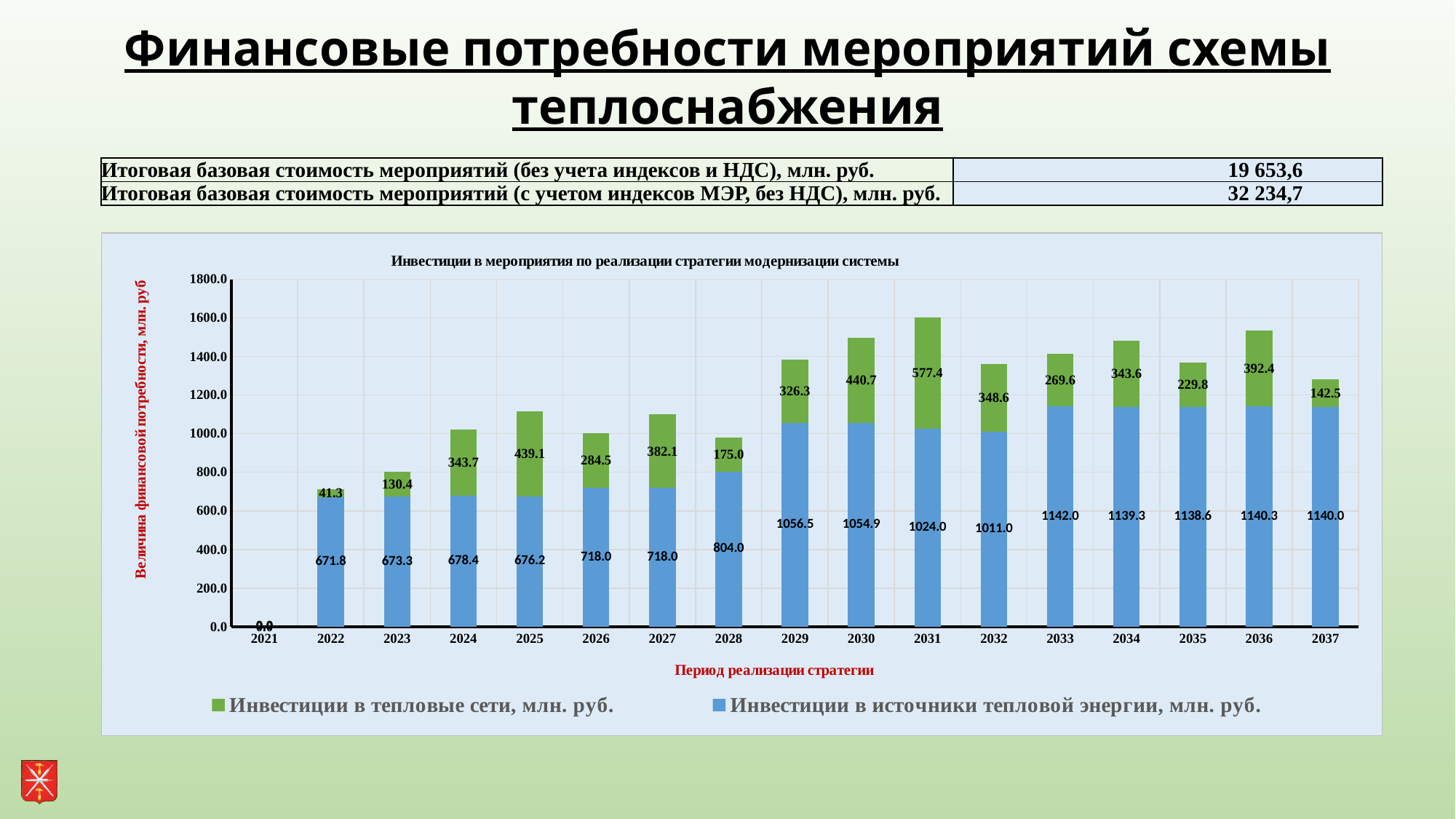
Which is larger: 'Инвестиции в тепловые сети, млн. руб.' in 2024 or in 2027? 2027 How many series does the chart legend list? 2 What is the difference between 'Инвестиции в тепловые сети, млн. руб.' in 2031 and in 2030? 136.7 What is the value of 'Инвестиции в источники тепловой энергии, млн. руб.' for 2028? 804.0 What is the value of 'Инвестиции в тепловые сети, млн. руб.' for 2031? 577.4 Among the years with a non-zero value, in which year is 'Инвестиции в тепловые сети, млн. руб.' the lowest? 2022 What type of chart is shown on the slide? bar chart What is the total height of the stacked bar for 2031? 1601.4 How many years are shown on the x axis of the chart? 17 What is the title of the chart? Инвестиции в мероприятия по реализации стратегии модернизации системы Is the total of the stacked bar for 2029 greater or less than 1200? greater In which year is 'Инвестиции в тепловые сети, млн. руб.' the highest? 2031